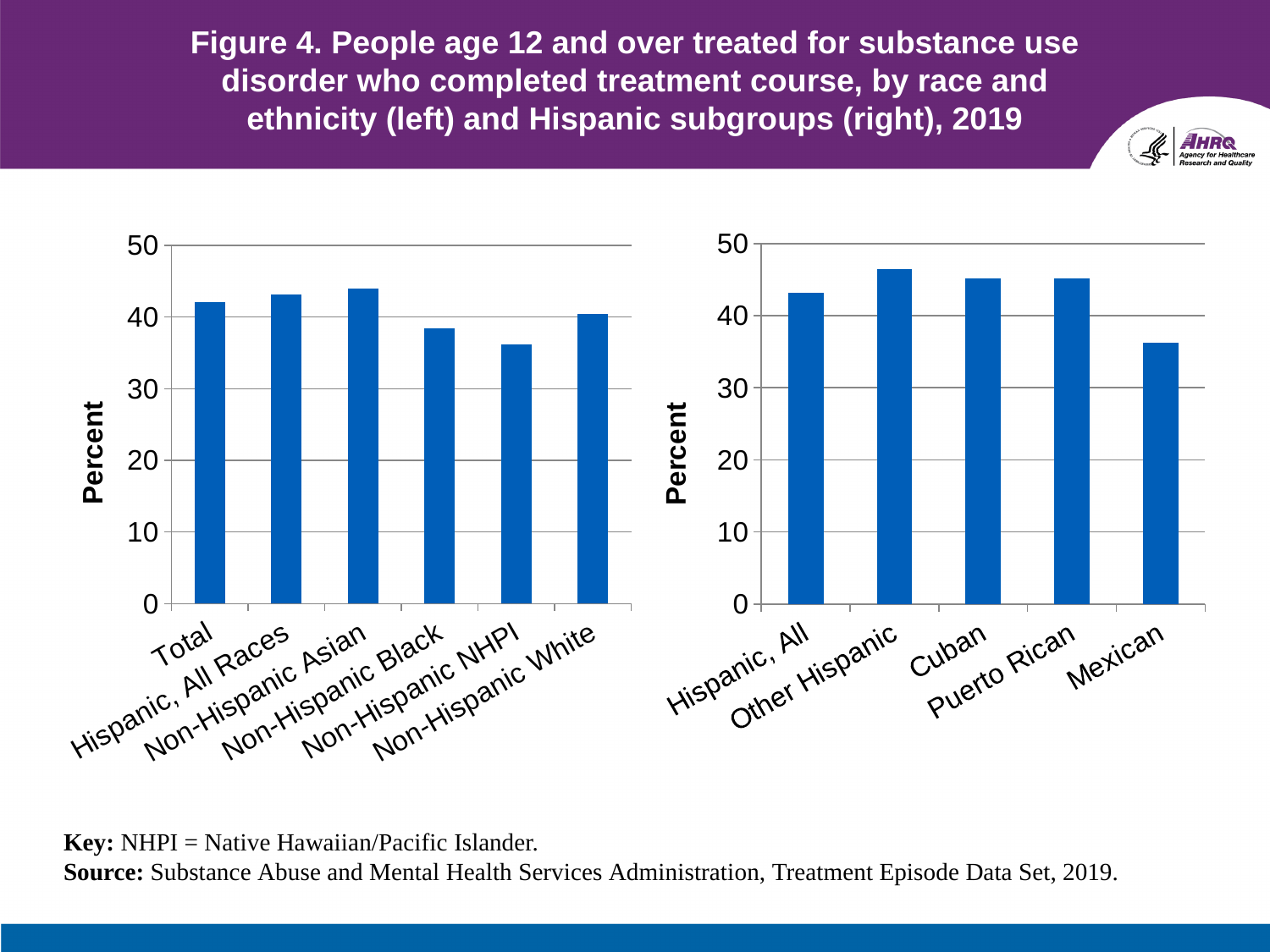
How many categories are shown in the right chart (Hispanic subgroups)? 5 In the right chart, which is larger: the value for Hispanic, All or the value for Mexican? Hispanic, All In the right chart (Hispanic subgroups), which category has the lowest value? Mexican In the left chart, is the value for Non-Hispanic NHPI greater or less than 40? less In the left chart, which is larger: the value for Non-Hispanic Black or the value for Non-Hispanic White? Non-Hispanic White In the right chart, is the value for Other Hispanic greater or less than 40? greater In the left chart (by race and ethnicity), which category has the lowest value? Non-Hispanic NHPI How many categories are shown in the left chart (by race and ethnicity)? 6 In the left chart, is the value for Non-Hispanic Asian greater or less than 40? greater What type of chart is used on this slide? Bar chart In the right chart (Hispanic subgroups), which category has the highest value? Other Hispanic